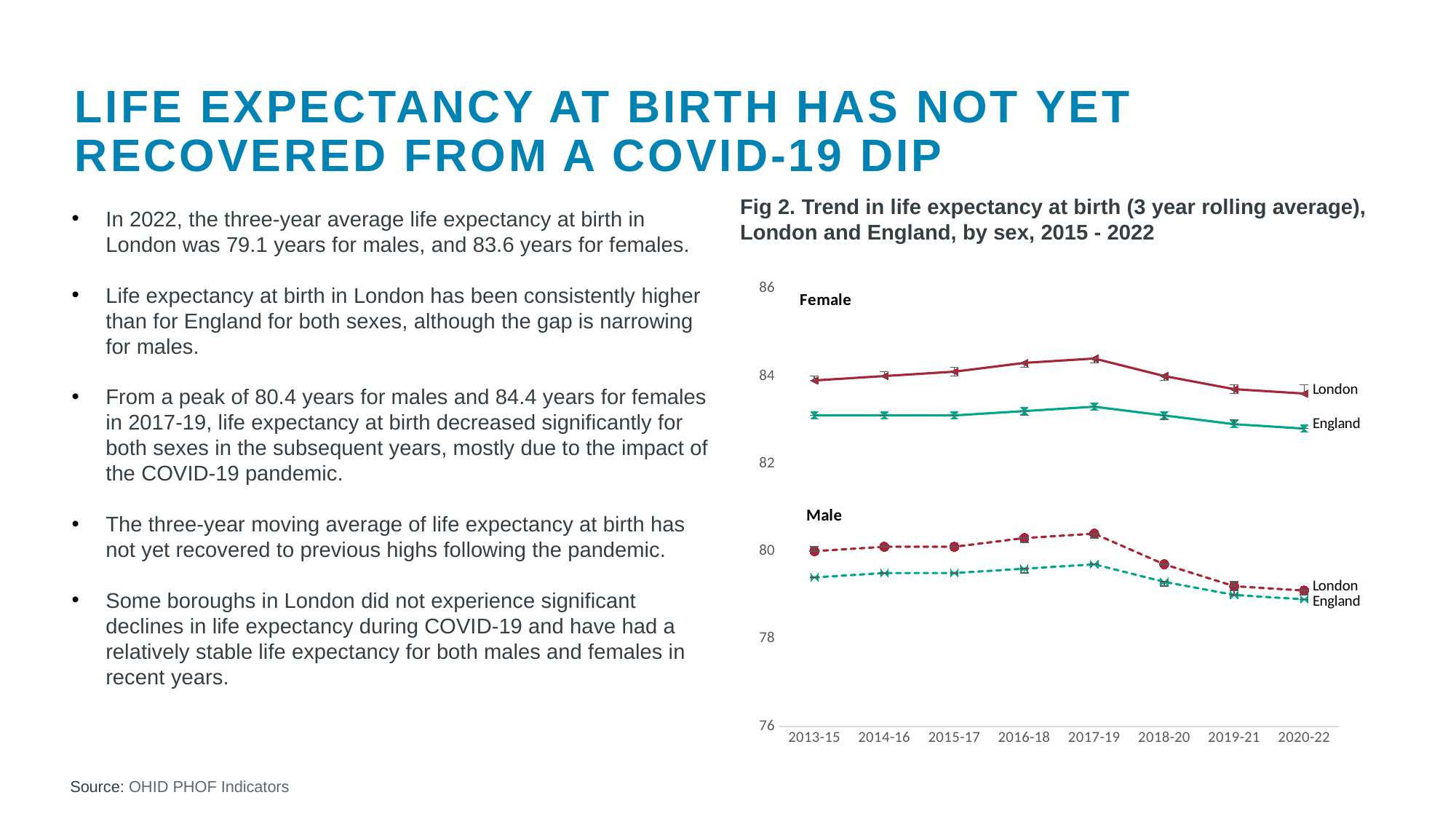
How many lines are plotted in Fig 2? 4 In which period does the Female London line reach its highest value? 2017-19 Is the Male London value for 2017-19 greater or less than 80? greater Is the Male England value for 2020-22 greater or less than 80? less In which period does the Male London line reach its highest value? 2017-19 In 2020-22, which is higher for females: London or England? London Is the Female London value for 2017-19 greater or less than 84? greater How many time periods are shown on the x axis of Fig 2? 8 Does the Male London line rise or fall from 2017-19 to 2020-22? fall What kind of chart is Fig 2? line chart What is the first period shown on the x axis of Fig 2? 2013-15